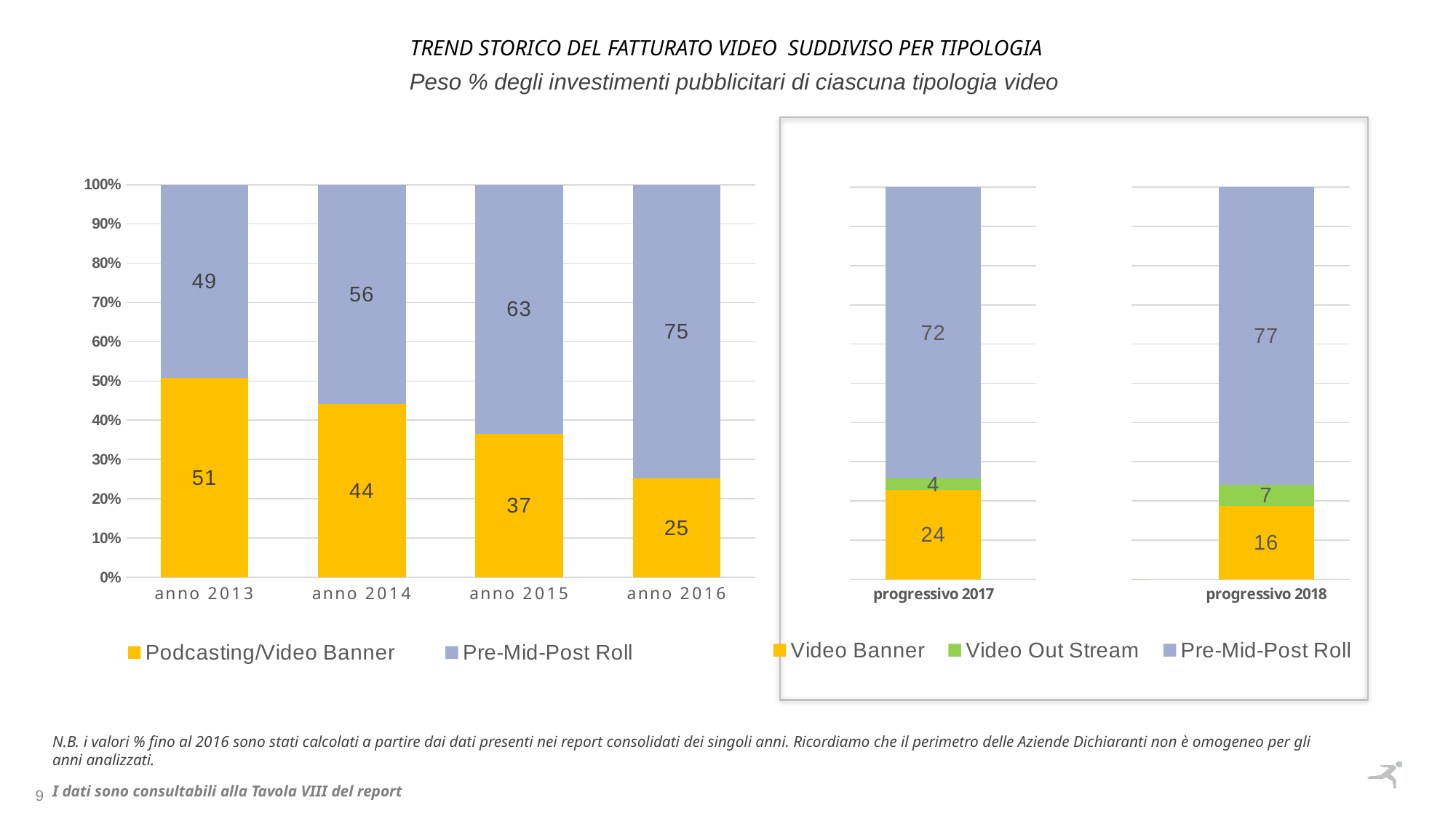
In the left chart (anno 2013–2016), what is the value for Podcasting/Video Banner in anno 2013? 51 In the left chart (anno 2013–2016), what is the difference between the Pre-Mid-Post Roll values for anno 2015 and anno 2014? 7 In the right chart (progressivo 2017–2018), what is the value for Video Banner in progressivo 2017? 24 In the left chart (anno 2013–2016), does the value for Podcasting/Video Banner rise or fall from anno 2013 to anno 2016? fall In the left chart (anno 2013–2016), which year has the lowest value for Podcasting/Video Banner? anno 2016 In the right chart (progressivo 2017–2018), which is larger: Video Banner in progressivo 2017 or Video Banner in progressivo 2018? progressivo 2017 How many categories are shown on the x axis of the left chart (anno 2013–2016)? 4 What kind of chart is the left chart (anno 2013–2016)? stacked bar chart In the right chart (progressivo 2017–2018), what is the value for Video Out Stream in progressivo 2018? 7 How many series does the legend of the right chart (progressivo 2017–2018) list? 3 In the left chart (anno 2013–2016), what is the value for Pre-Mid-Post Roll in anno 2016? 75 In the left chart (anno 2013–2016), which year has the highest value for Pre-Mid-Post Roll? anno 2016